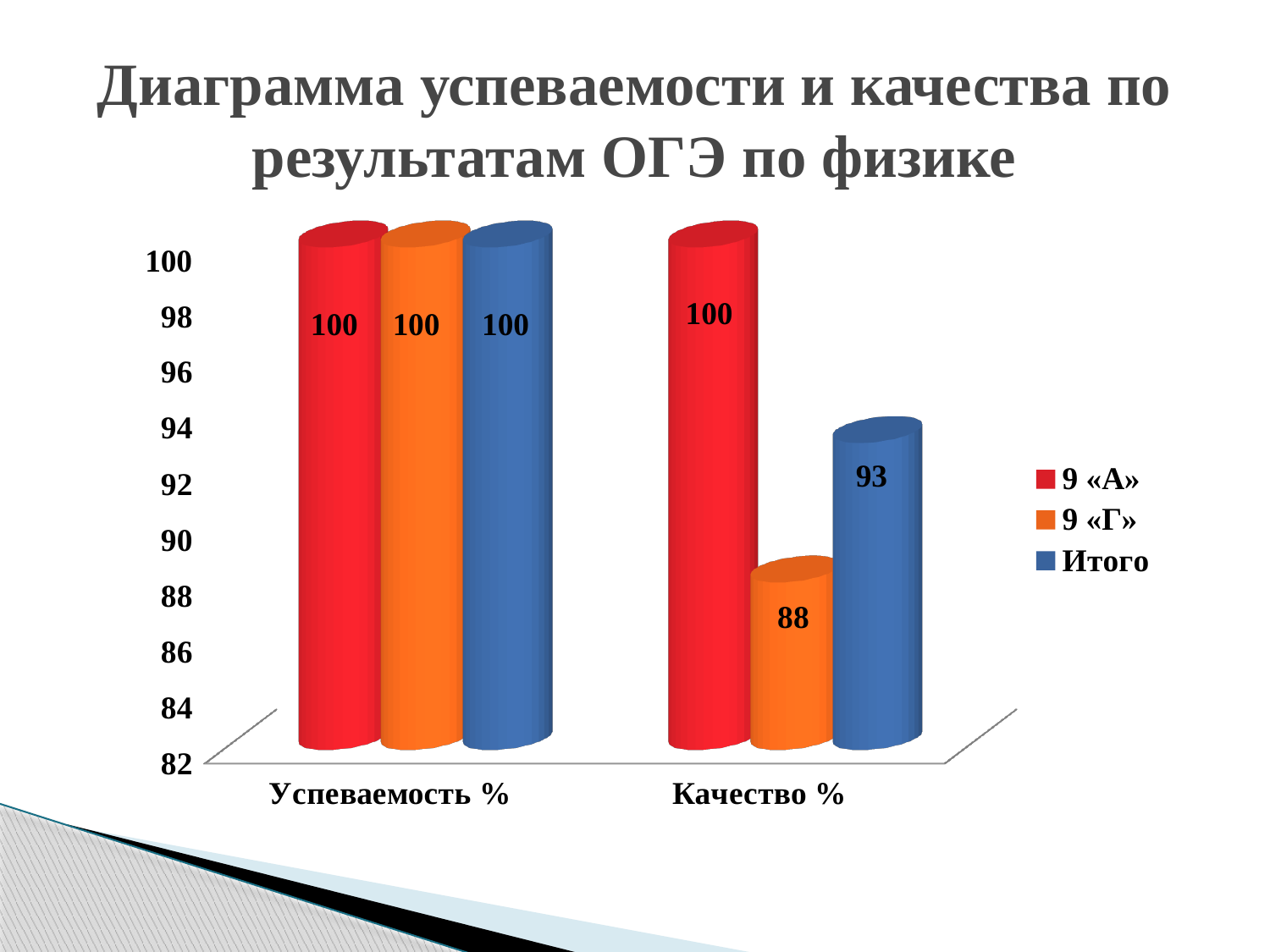
Which series has the lowest value in the Качество % category? 9 «Г» Which series has the highest value in the Качество % category? 9 «А» What is the value for 9 «А» in the Успеваемость % category? 100 How many categories are shown on the x axis? 2 What kind of chart is shown on the slide? bar chart How many series does the legend list? 3 What is the difference between the Итого and 9 «Г» values in the Качество % category? 5 Which is larger in the Качество % category: the value for Итого or the value for 9 «Г»? Итого What colour represents the Итого series in the legend? blue What is the value for 9 «Г» in the Качество % category? 88 What is the value for Итого in the Качество % category? 93 What is the difference between the 9 «А» and 9 «Г» values in the Качество % category? 12